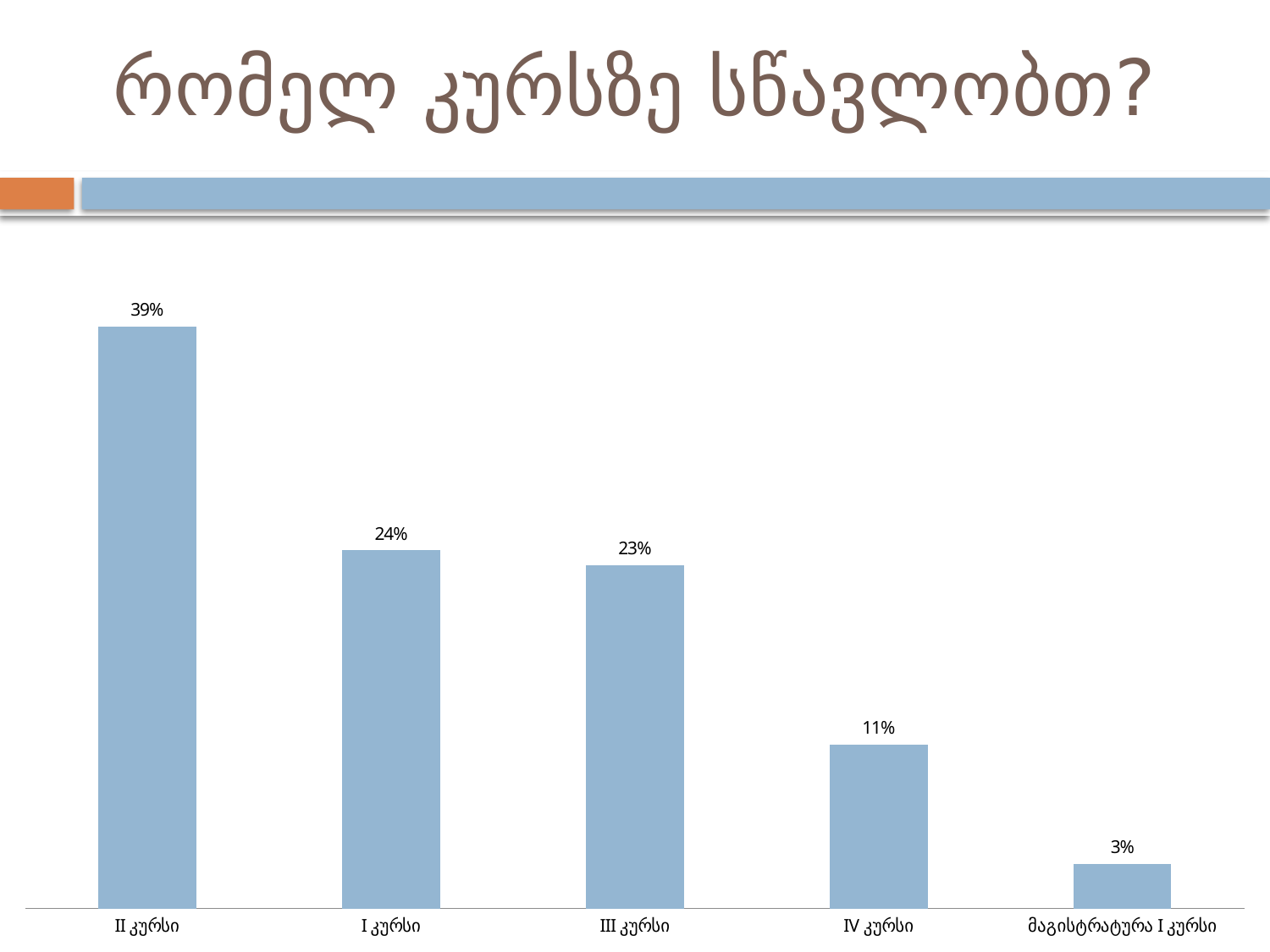
Which category has the highest value? II კურსი Which category has the lowest value? მაგისტრატურა I კურსი What is the value for III კურსი? 23% How many categories are shown on the chart? 5 What is the difference between the values for II კურსი and I კურსი? 15% What is the difference between the values for IV კურსი and მაგისტრატურა I კურსი? 8% Which is larger, the value for II კურსი or the value for IV კურსი? II კურსი What is the value for I კურსი? 24% What is the value for მაგისტრატურა I კურსი? 3% What is the value for II კურსი? 39% What kind of chart is shown on the slide? Bar chart What is the value for IV კურსი? 11%